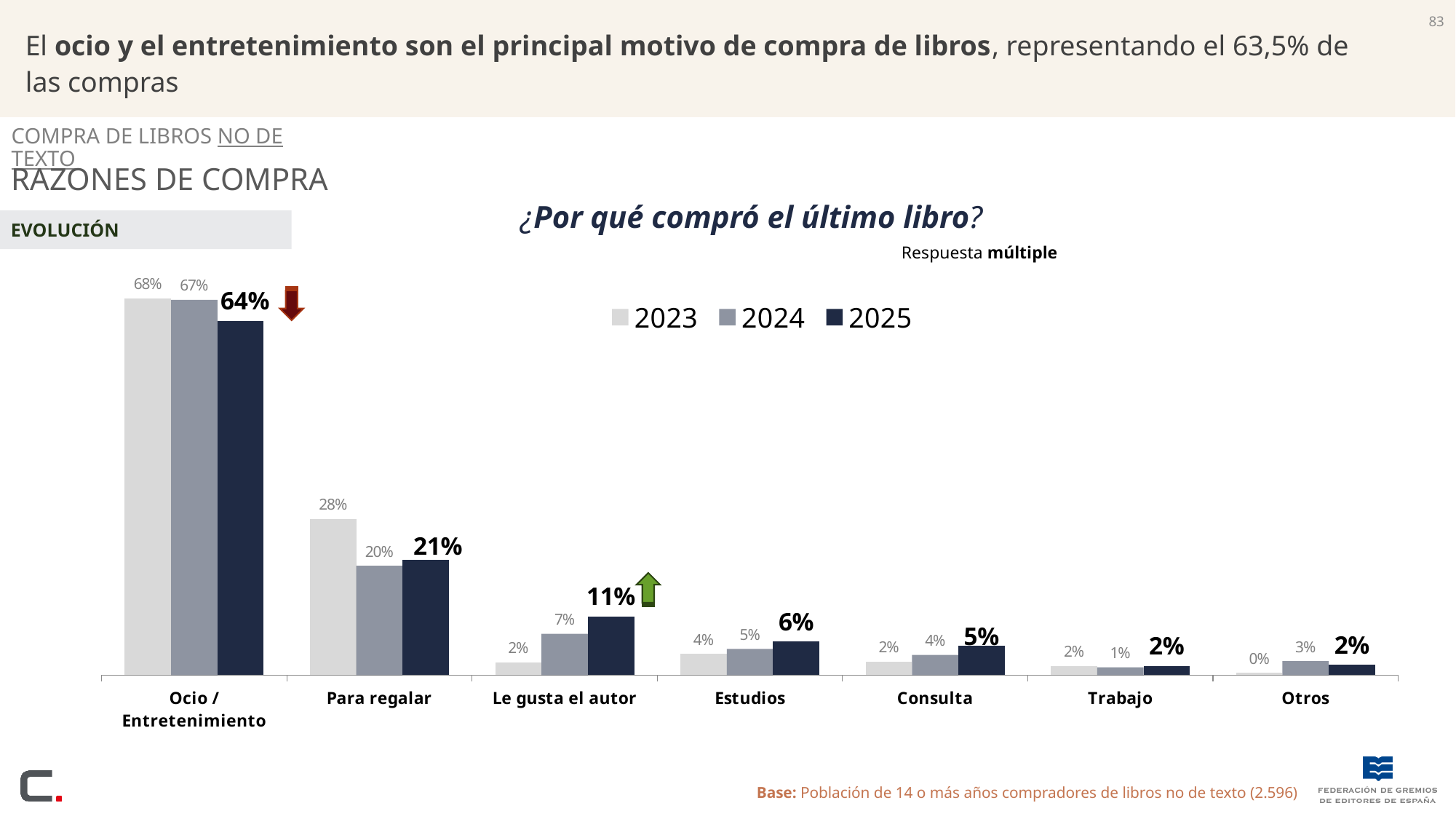
What is the 2024 value for Le gusta el autor? 7% How many series does the legend list? 3 Which category has the highest 2025 value? Ocio / Entretenimiento What is the title of the chart? ¿Por qué compró el último libro? Which is larger for Para regalar, the 2024 value or the 2025 value? 2025 What kind of chart is shown? Bar chart What is the difference between the 2024 and 2025 values for Le gusta el autor? 4% What is the 2023 value for Para regalar? 28% How many categories are shown on the x axis? 7 Which category has the lowest 2023 value? Otros What is the difference between the 2023 and 2025 values for Ocio / Entretenimiento? 4% What is the 2025 value for Ocio / Entretenimiento? 64%